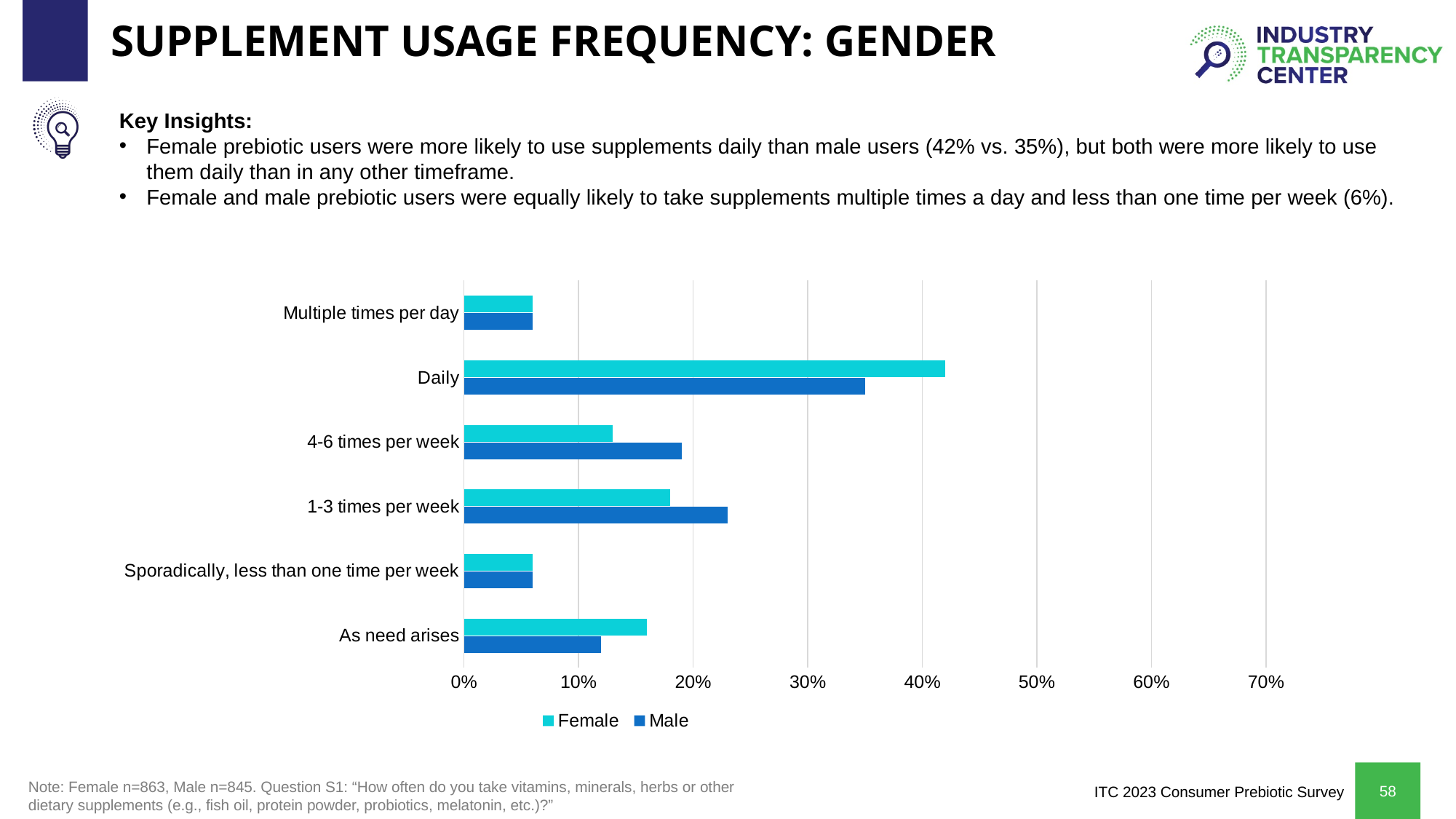
Is the Male value for Daily greater or less than 30%? greater What kind of chart is shown on the slide? bar chart For the 4-6 times per week category, which is larger, the Female value or the Male value? Male For the Daily category, which is larger, the Female value or the Male value? Female Which usage frequency category has the highest value for Male? Daily Which usage frequency category has the highest value for Female? Daily For the As need arises category, which is larger, the Female value or the Male value? Female Is the Male value for 1-3 times per week greater or less than 20%? greater Is the Female value for 4-6 times per week greater or less than 20%? less Which series is shown in the darker blue colour in the legend? Male How many series does the legend list? 2 How many usage frequency categories are plotted on the chart? 6